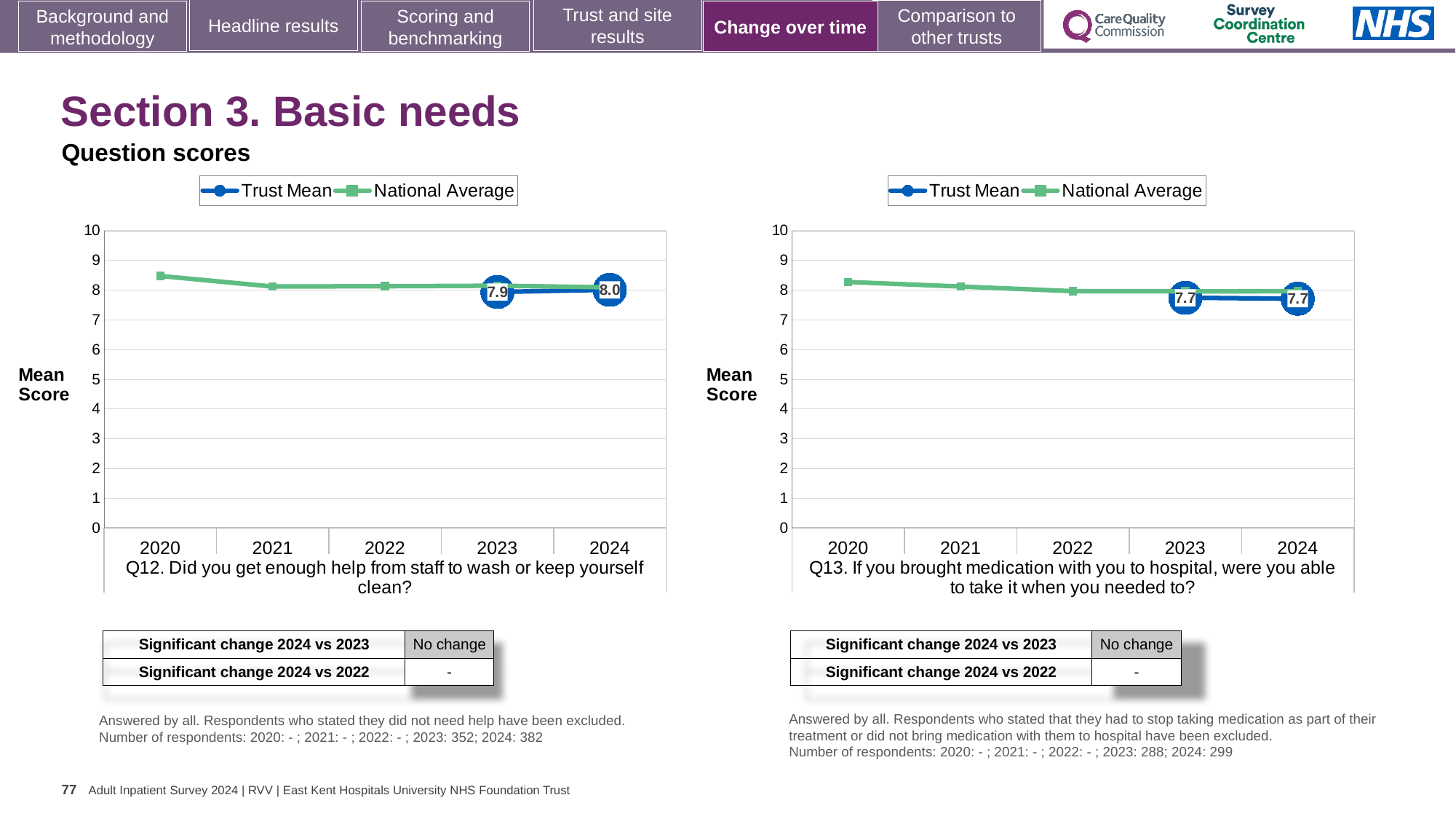
What type of chart is the Q13 chart (right)? Line chart How many series does the legend of the Q13 chart (right) list? 2 On the Q12 chart (left), what is the Trust Mean for 2024? 8.0 On the Q12 chart (left), what is the difference between the Trust Mean for 2024 and 2023? 0.1 On the Q13 chart (right), does the National Average rise or fall from 2020 to 2022? Fall On the Q13 chart (right), what is the Trust Mean for 2023? 7.7 On the Q12 chart (left), is the National Average for 2020 greater or less than 8? greater On the Q12 chart (left), what is the Trust Mean for 2023? 7.9 How many years are shown on the x axis of the Q12 chart (left)? 5 On the Q13 chart (right), is the National Average for 2020 greater or less than 8? greater On the Q12 chart (left), which year has the higher Trust Mean, 2023 or 2024? 2024 On the Q13 chart (right), what is the Trust Mean for 2024? 7.7